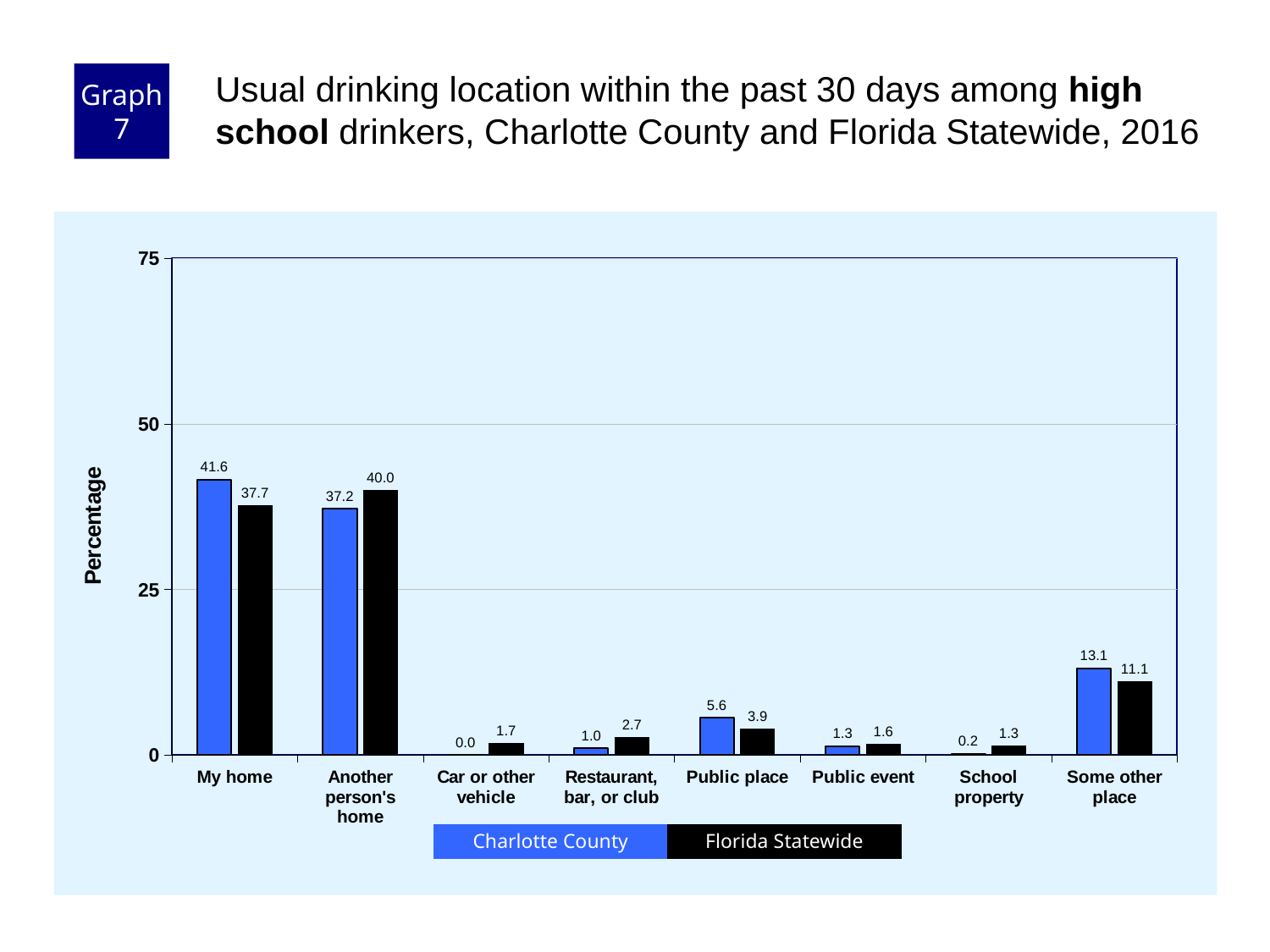
What kind of chart is shown? bar chart How many categories are shown on the x axis? 8 What is the difference between the Charlotte County and Florida Statewide values for My home? 3.9 Which category has the highest Charlotte County value? My home What is the Charlotte County value for Some other place? 13.1 Which is larger for Public place: Charlotte County or Florida Statewide? Charlotte County What is the Charlotte County value for My home? 41.6 What is the Florida Statewide value for Another person's home? 40.0 What is the label of the y axis? Percentage How many series does the legend list? 2 Which category has the lowest Charlotte County value? Car or other vehicle Is the Florida Statewide value for Another person's home greater or less than 25? greater